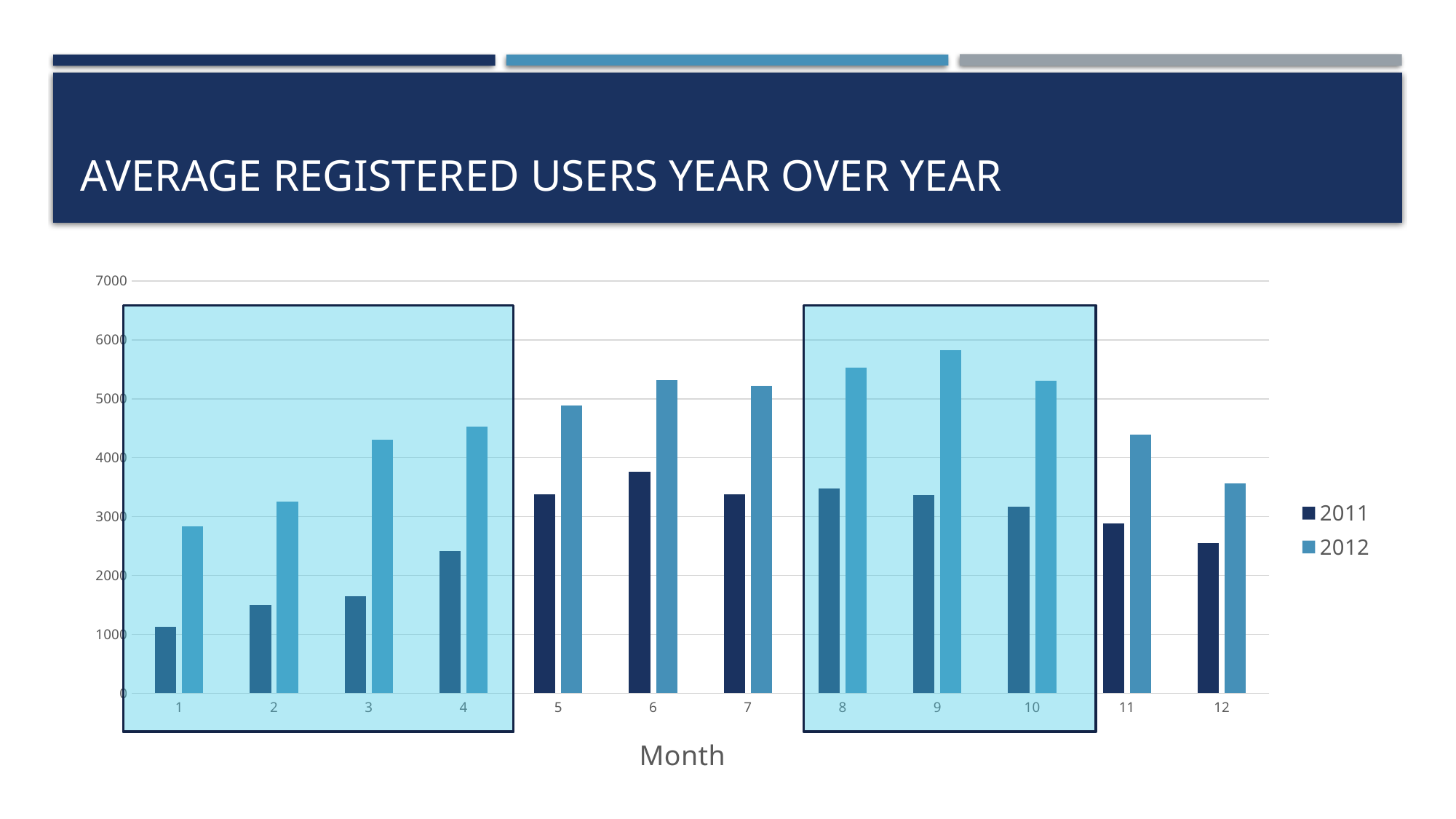
How many series does the legend list? 2 How many months are shown along the x axis? 12 Is the 2012 value for month 6 greater or less than 5000? greater Is the 2012 value for month 9 greater or less than 6000? less Which month has the highest value for the 2012 series? 9 Which month has the lowest value for the 2011 series? 1 Is the 2011 value for month 1 greater or less than 2000? less Which month has the highest value for the 2011 series? 6 Which month has the lowest value for the 2012 series? 1 For month 3, which series has the larger value, 2011 or 2012? 2012 What is the title of the chart on the slide? Average Registered Users Year Over Year What kind of chart is shown on the slide? bar chart